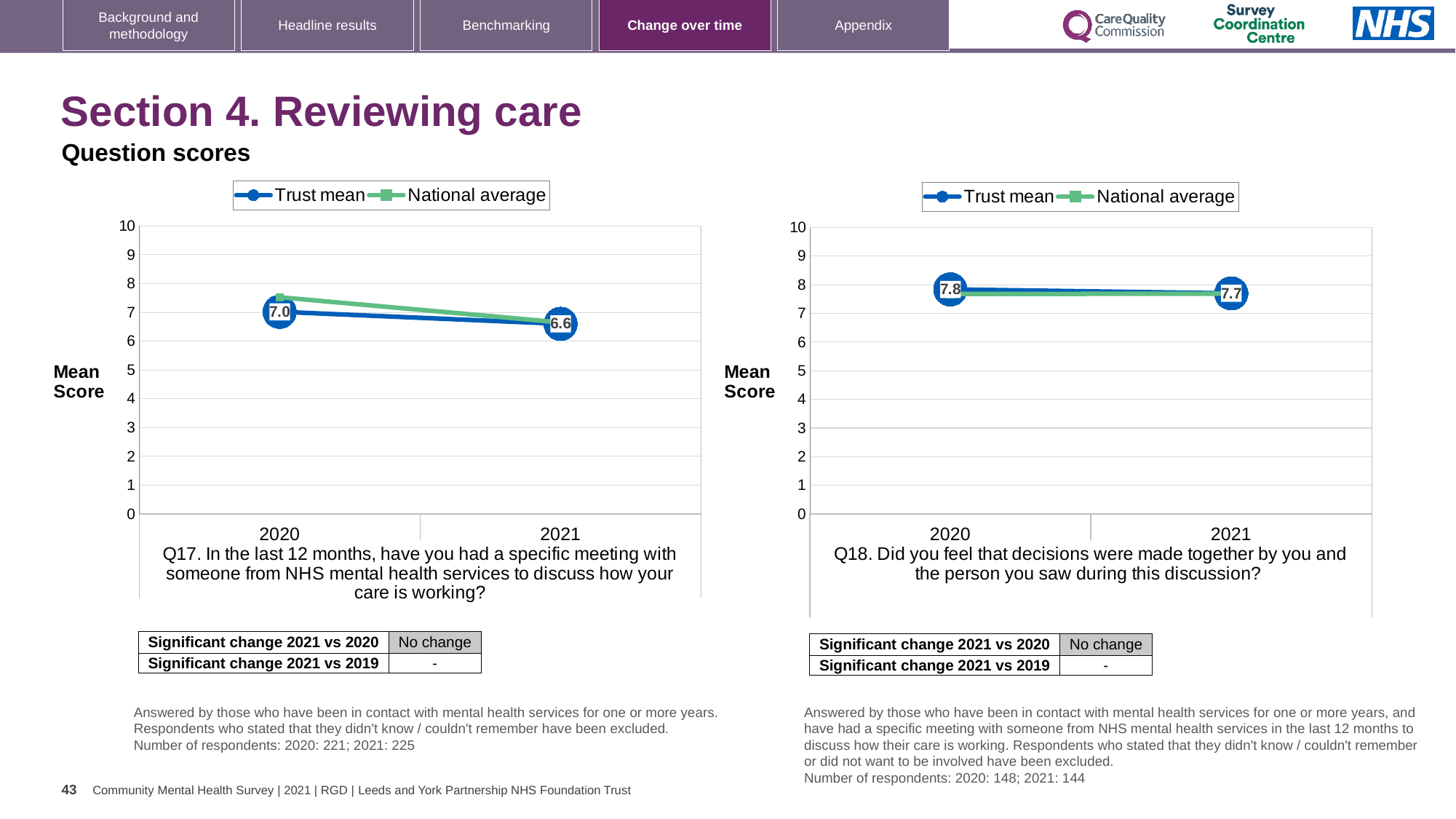
What kind of chart is the Q17 chart on the left? line chart In the Q17 chart on the left, which is larger in 2020, the Trust mean or the National average? National average In the Q18 chart on the right, what is the difference between the Trust mean in 2020 and in 2021? 0.1 In the Q17 chart on the left, by how much did the Trust mean fall from 2020 to 2021? 0.4 In the Q17 chart on the left, which year has the higher Trust mean score? 2020 In the Q17 chart on the left, does the Trust mean rise or fall from 2020 to 2021? fall In the Q17 chart on the left, what is the Trust mean score for 2020? 7.0 In the Q18 chart on the right, what is the Trust mean score for 2020? 7.8 In the Q17 chart on the left, is the National average for 2020 greater or less than 7? greater In the Q18 chart on the right, what is the Trust mean score for 2021? 7.7 In the Q17 chart on the left, what is the Trust mean score for 2021? 6.6 How many series does the legend of the Q18 chart on the right list? 2